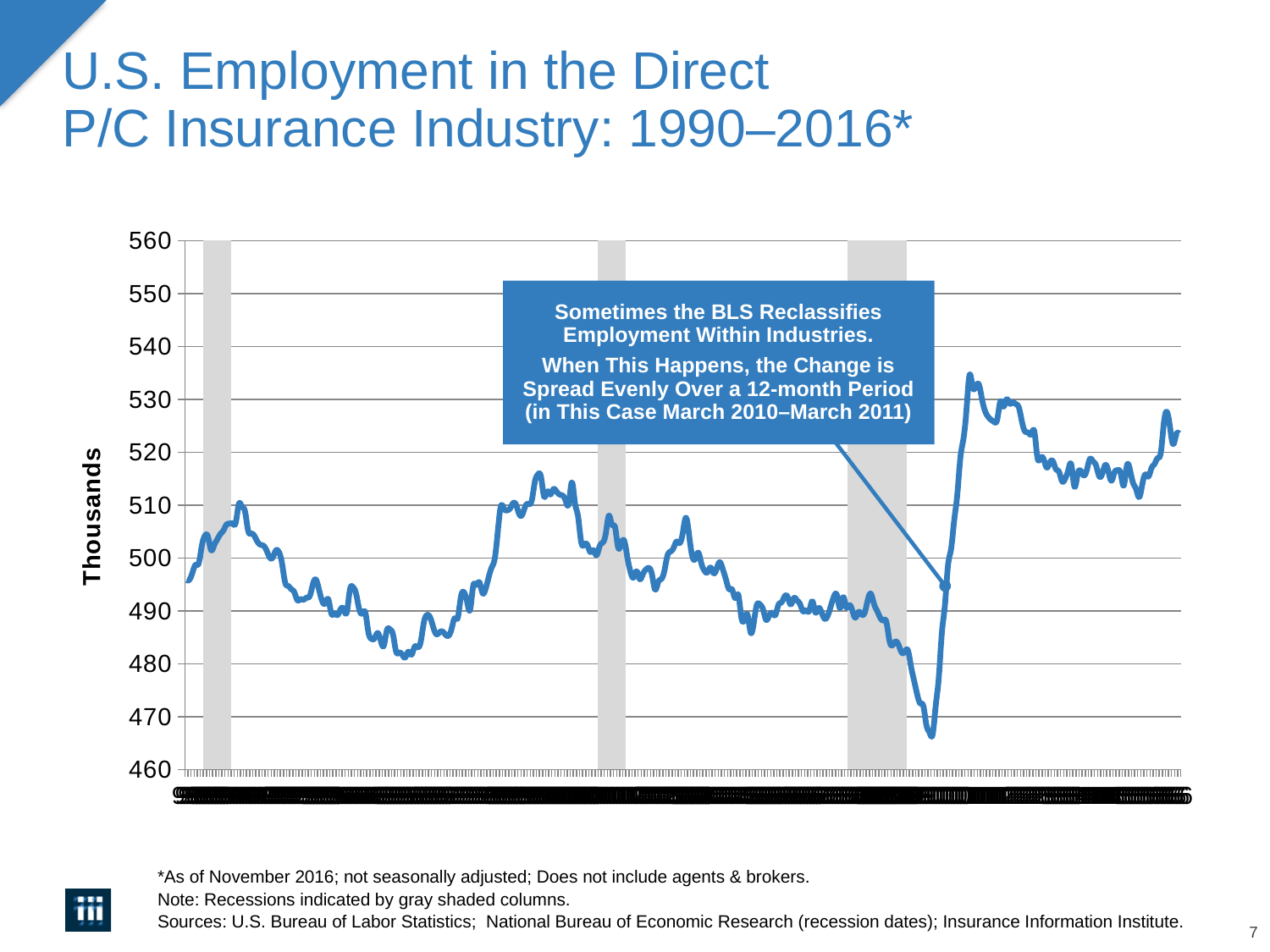
Is the lowest point of the line greater or less than 470? less Does the line rise or fall during the third (rightmost) gray shaded recession column? fall How many gray shaded recession columns appear on the chart? 3 Is the value at the end of the line higher or lower than the value at the start of the line? higher Is the value at the start of the line (left end) greater or less than 500? less What kind of chart is shown on the slide? line chart What is the highest value shown on the vertical axis? 560 Is the highest point of the line greater or less than 530? greater What is the label on the vertical axis of the chart? Thousands What is the title of the chart on the slide? U.S. Employment in the Direct P/C Insurance Industry: 1990–2016*